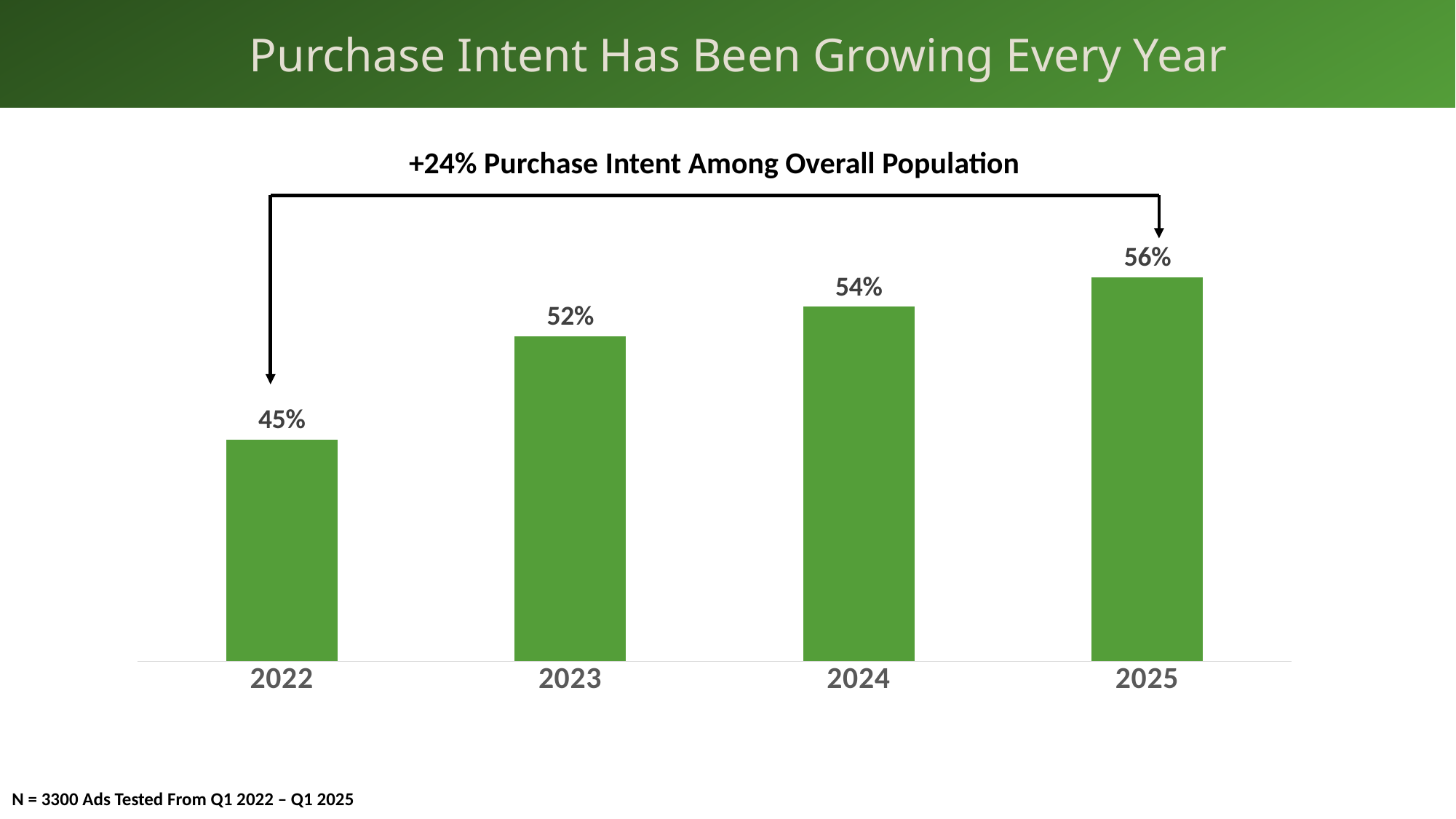
How many years are shown on the chart? 4 What is the purchase intent value for 2024? 54% What is the difference in purchase intent between 2025 and 2022? 11 percentage points What is the purchase intent value for 2025? 56% Which year has the highest purchase intent? 2025 What is the difference in purchase intent between 2023 and 2022? 7 percentage points What is the purchase intent value for 2023? 52% Which year has a higher purchase intent, 2023 or 2024? 2024 Do the purchase intent values rise or fall from 2022 to 2025? Rise Which year has the lowest purchase intent? 2022 What is the purchase intent value for 2022? 45% What kind of chart is shown on the slide? Bar chart